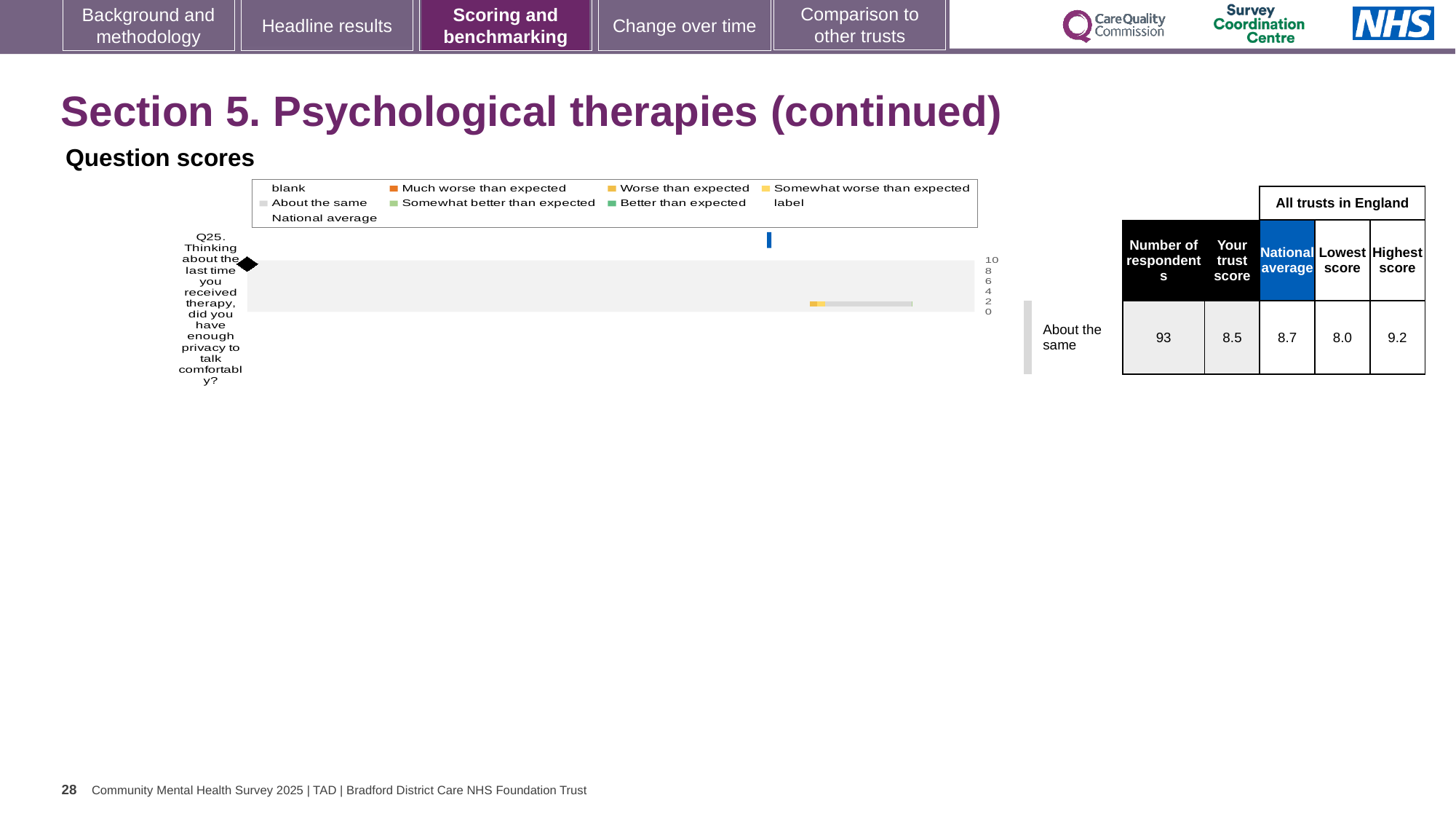
In the table next to the Question scores chart, what is the trust score for Q25? 8.5 What benchmarking category is shown for Q25 in the Question scores chart? About the same Which question is shown in the Question scores chart? Q25. Thinking about the last time you received therapy, did you have enough privacy to talk comfortably? In the table next to the Question scores chart, which is larger for Q25: the trust score or the national average? National average How many questions are plotted in the Question scores chart? 1 In the table next to the Question scores chart, what is the lowest score across all trusts in England for Q25? 8.0 In the table next to the Question scores chart, what is the difference between the highest score and the lowest score for Q25? 1.2 What is the highest value shown on the axis of the Question scores chart? 10 In the table next to the Question scores chart, what is the highest score across all trusts in England for Q25? 9.2 In the table next to the Question scores chart, what is the national average for Q25? 8.7 In the table next to the Question scores chart, what is the number of respondents for Q25? 93